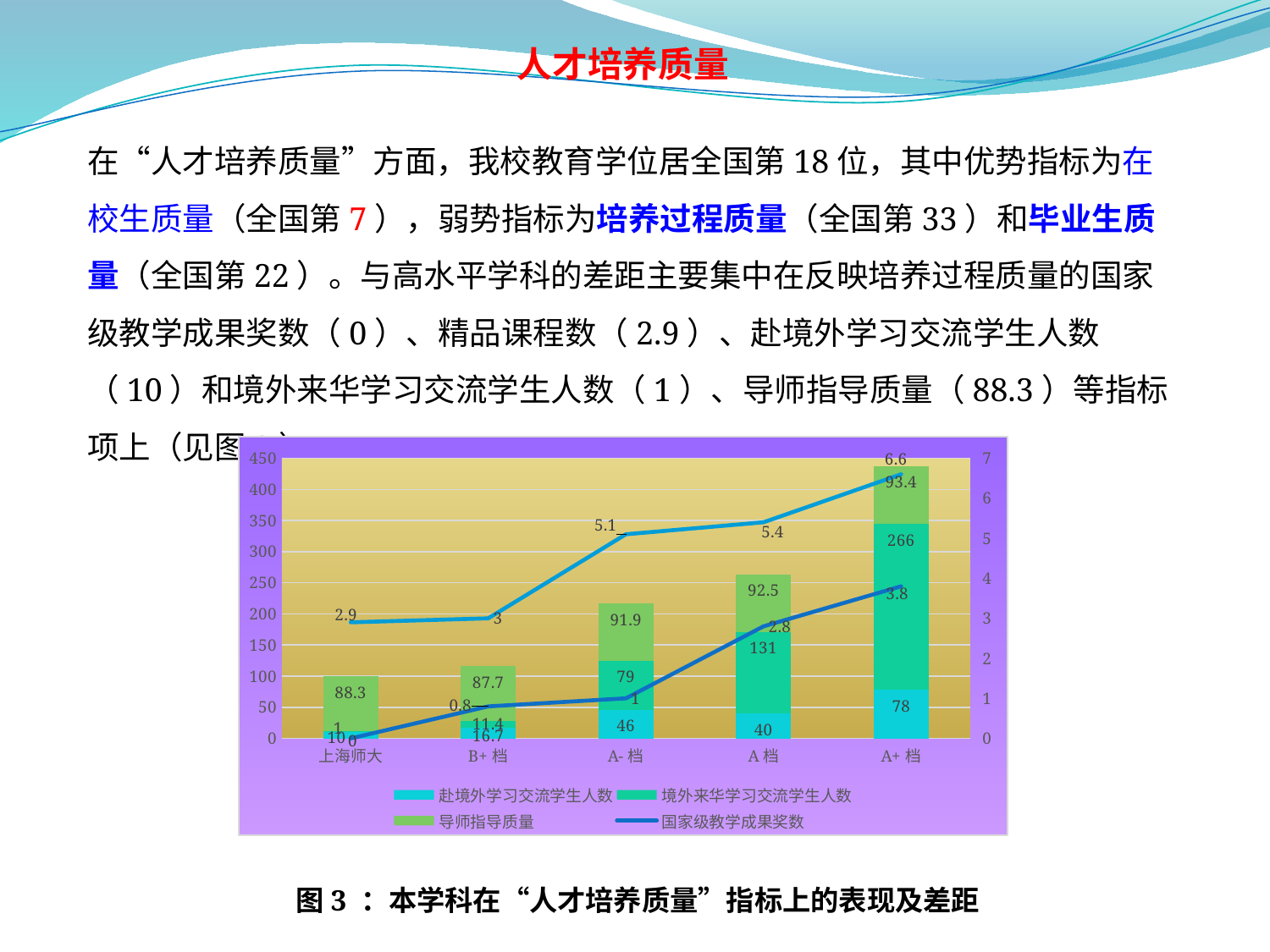
What is the value of 国家级教学成果奖数 for A 档? 2.8 How many categories are shown on the x axis? 5 What is the difference in 赴境外学习交流学生人数 between A+ 档 and 上海师大? 68 What is the total of the stacked bar for 上海师大? 99.3 Which category has the highest value for 境外来华学习交流学生人数? A+ 档 Which has a larger value for 赴境外学习交流学生人数, A- 档 or A 档? A- 档 What is the value of 导师指导质量 for 上海师大? 88.3 Does the 国家级教学成果奖数 line rise or fall from 上海师大 to A+ 档? rises Which category has the lowest value for 赴境外学习交流学生人数? 上海师大 What is the value of 境外来华学习交流学生人数 for A+ 档? 266 How many series does the legend list? 4 What is the value of 赴境外学习交流学生人数 for A- 档? 46